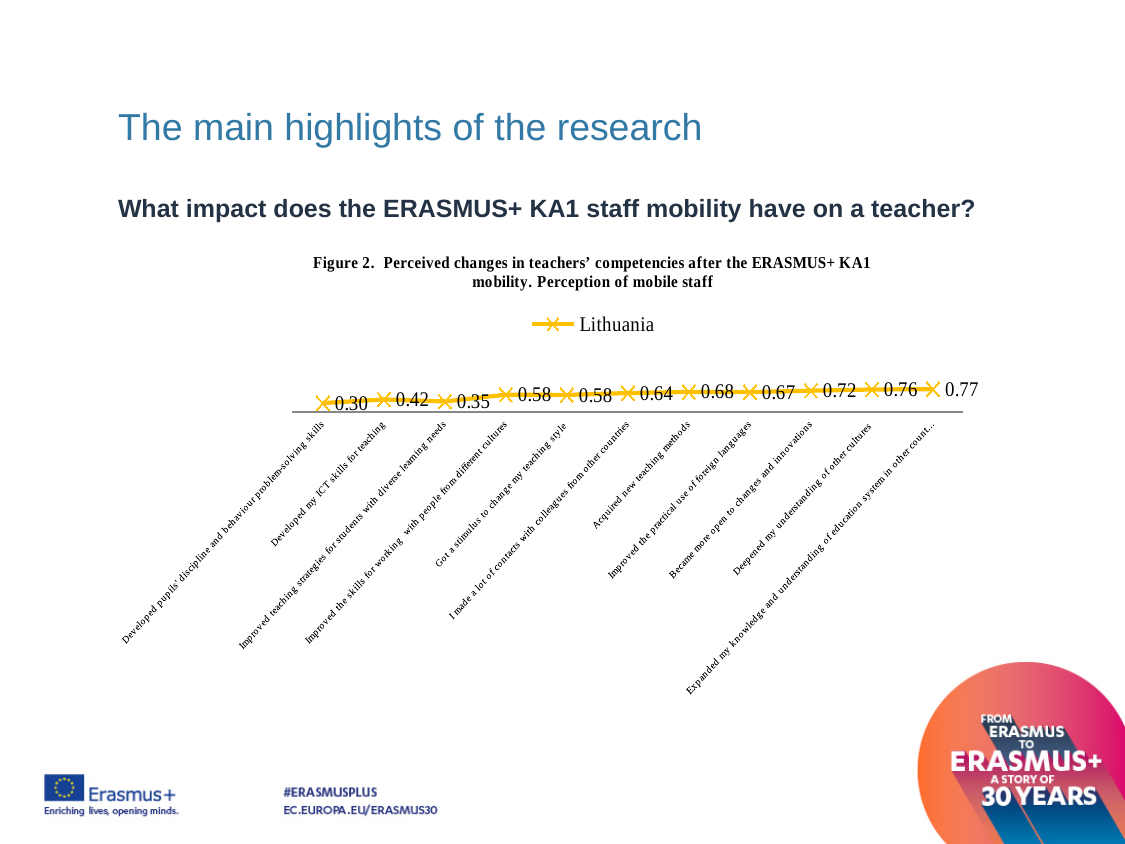
How many series does the legend list in Figure 2? 1 How many categories are plotted in Figure 2? 11 Which category has the lowest value in Figure 2? Developed pupils' discipline and behaviour problem-solving skills What is the value for 'Deepened my understanding of other cultures' in Figure 2? 0.76 What is the highest value plotted in Figure 2? 0.77 What is the name of the series shown in the legend of Figure 2? Lithuania In Figure 2, which is larger: the value for 'Improved teaching strategies for students with diverse learning needs' or the value for 'Got a stimulus to change my teaching style'? Got a stimulus to change my teaching style In Figure 2, what is the difference between the values for 'Became more open to changes and innovations' and 'Developed my ICT skills for teaching'? 0.30 What is the value for 'Developed my ICT skills for teaching' in Figure 2? 0.42 Do the values in Figure 2 generally rise or fall from left to right along the x axis? rise What kind of chart is shown in Figure 2? line chart What is the value for 'Acquired new teaching methods' in Figure 2? 0.68